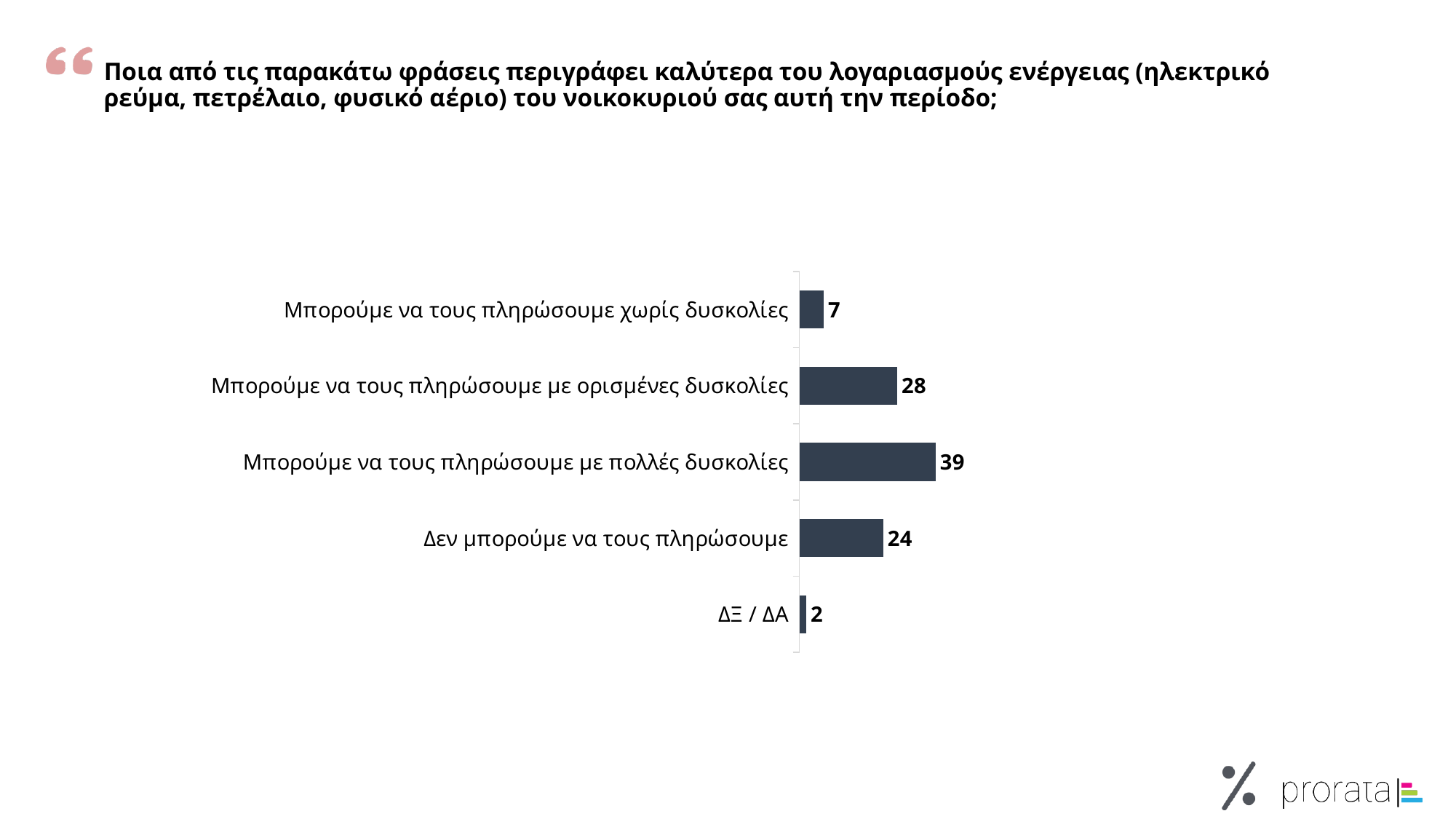
What is the value for "Μπορούμε να τους πληρώσουμε με ορισμένες δυσκολίες"? 28 What is the total of the values for "Μπορούμε να τους πληρώσουμε με πολλές δυσκολίες" and "Δεν μπορούμε να τους πληρώσουμε"? 63 Which is larger: the value for "Μπορούμε να τους πληρώσουμε με ορισμένες δυσκολίες" or the value for "Δεν μπορούμε να τους πληρώσουμε"? Μπορούμε να τους πληρώσουμε με ορισμένες δυσκολίες What is the difference between the values for "Δεν μπορούμε να τους πληρώσουμε" and "Μπορούμε να τους πληρώσουμε χωρίς δυσκολίες"? 17 Which category has the highest value? Μπορούμε να τους πληρώσουμε με πολλές δυσκολίες How many categories are shown in the chart? 5 What is the difference between the values for "Μπορούμε να τους πληρώσουμε με πολλές δυσκολίες" and "Μπορούμε να τους πληρώσουμε με ορισμένες δυσκολίες"? 11 What is the value for "ΔΞ / ΔΑ"? 2 What is the value for "Δεν μπορούμε να τους πληρώσουμε"? 24 What is the value for "Μπορούμε να τους πληρώσουμε χωρίς δυσκολίες"? 7 Which category has the lowest value? ΔΞ / ΔΑ What kind of chart is shown on the slide? Bar chart